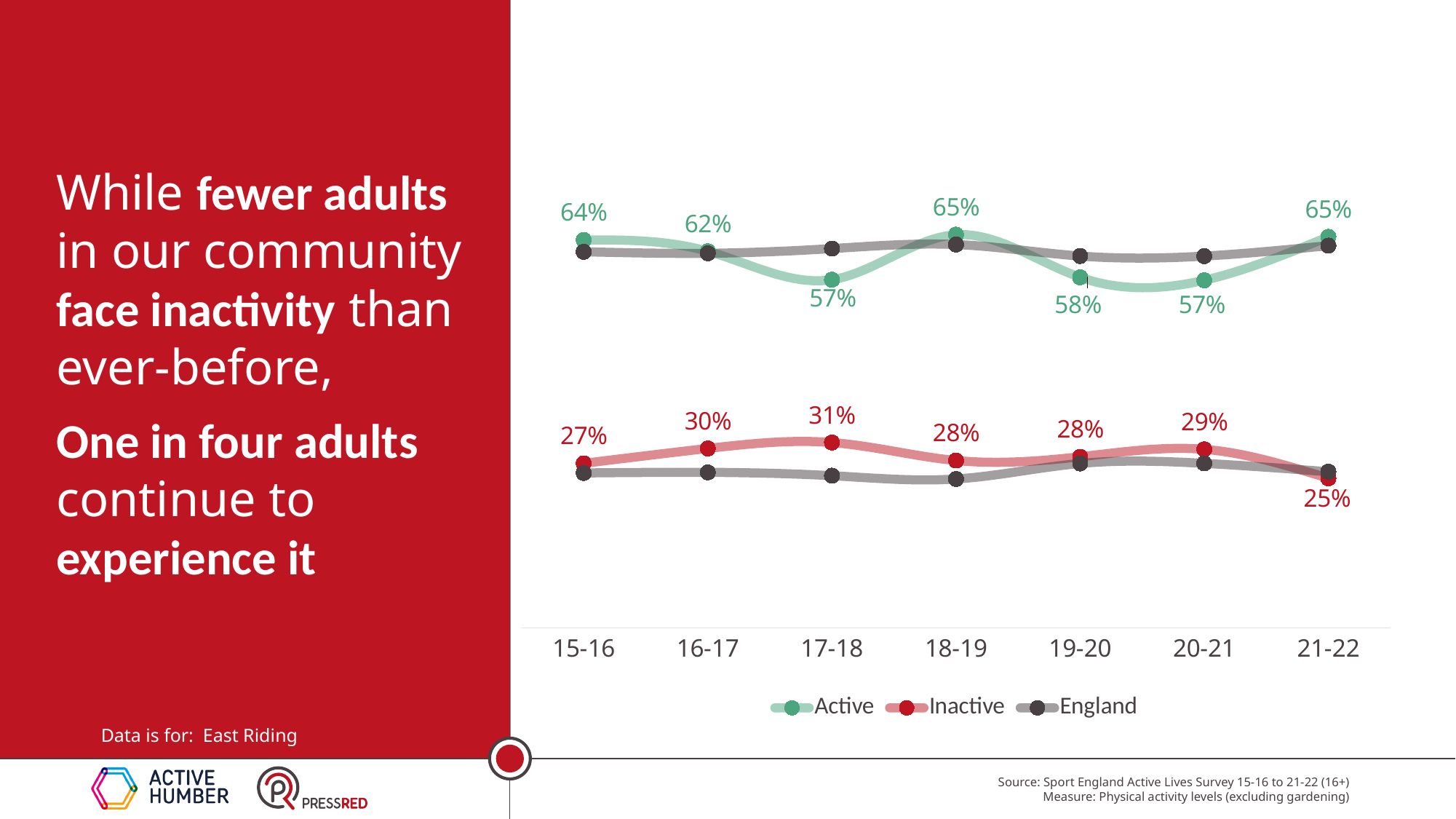
In which year is the Inactive value lowest? 21-22 How many series does the legend list? 3 What is the Inactive value for 17-18? 31% What is the Active value for 21-22? 65% What is the Active value for 15-16? 64% What is the Inactive value for 21-22? 25% In which year is the Inactive value highest? 17-18 What is the difference between the Active value for 15-16 and the Active value for 17-18? 7 percentage points What kind of chart is shown on the slide? Line chart How many years are shown on the x axis? 7 Does the Inactive value rise or fall from 20-21 to 21-22? Fall Which is larger, the Active value for 16-17 or the Active value for 19-20? 16-17 (62%)